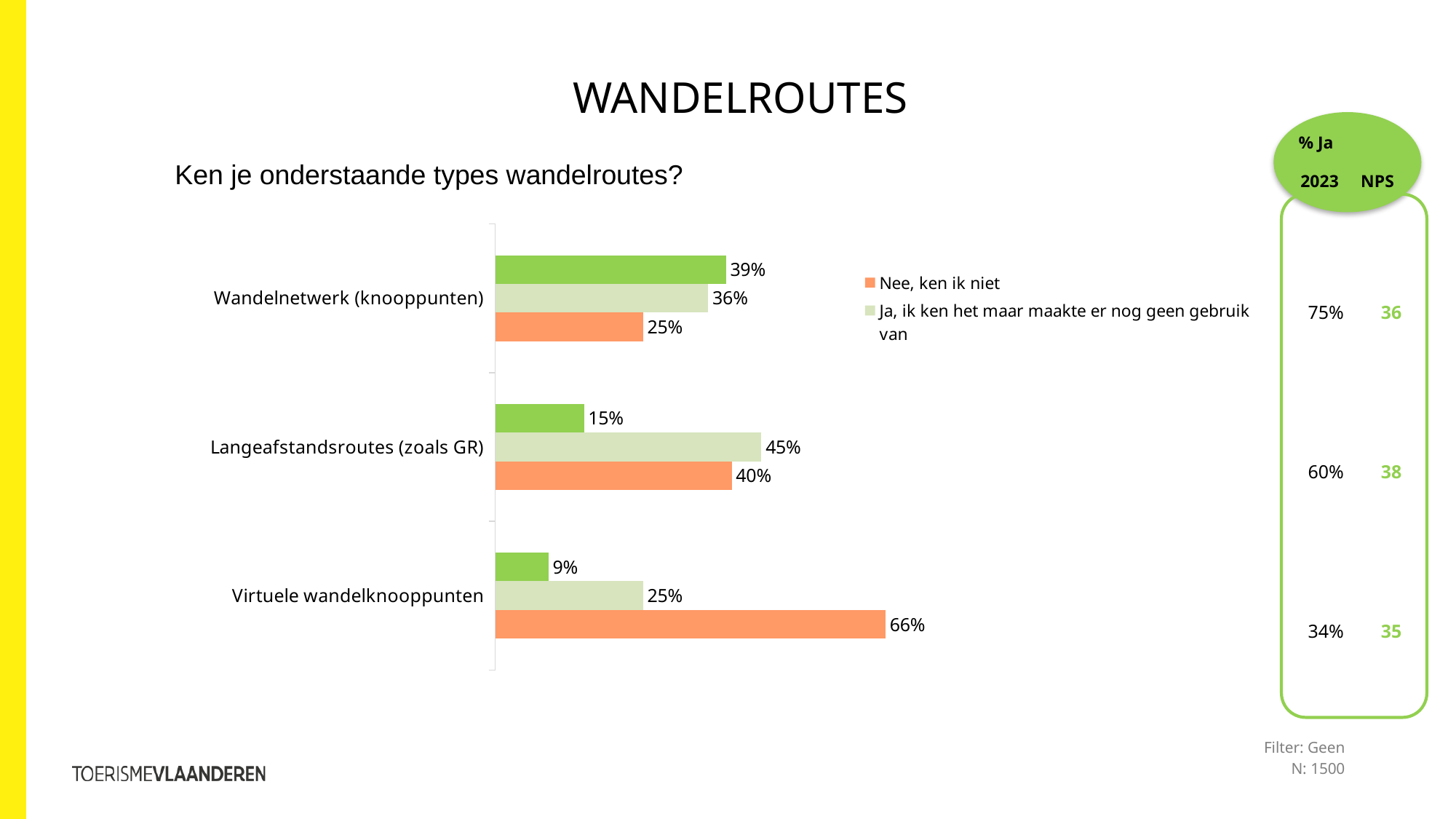
What is the value of "Nee, ken ik niet" for Wandelnetwerk (knooppunten)? 25% What colour represents "Nee, ken ik niet" in the chart? Orange What is the value of "Ja, ik ken het maar maakte er nog geen gebruik van" for Langeafstandsroutes (zoals GR)? 45% What is the value of "Nee, ken ik niet" for Virtuele wandelknooppunten? 66% For Langeafstandsroutes (zoals GR), which is larger: "Nee, ken ik niet" or "Ja, ik ken het maar maakte er nog geen gebruik van"? Ja, ik ken het maar maakte er nog geen gebruik van What is the difference between the "Nee, ken ik niet" values for Virtuele wandelknooppunten and Wandelnetwerk (knooppunten)? 41 percentage points Which category has the lowest value for "Ja, ik ken het maar maakte er nog geen gebruik van"? Virtuele wandelknooppunten Which category has the highest value for "Nee, ken ik niet"? Virtuele wandelknooppunten How many categories are shown on the chart? 3 What kind of chart is shown on the slide? Bar chart How many series does the legend list? 2 What value is shown on the dark green bar for Wandelnetwerk (knooppunten)? 39%